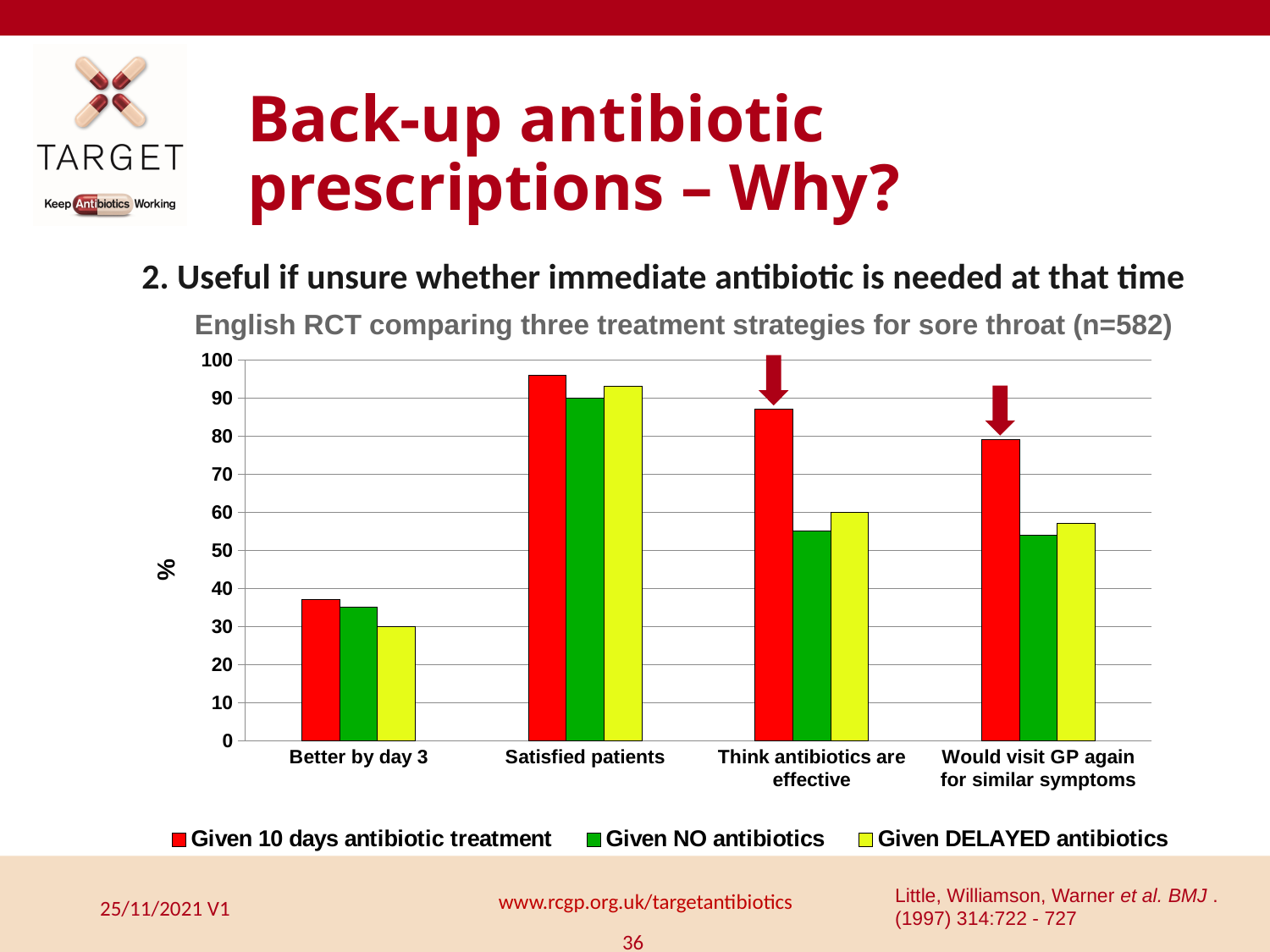
What kind of chart is shown on the slide? bar chart How many series does the chart's legend list? 3 Is the value for 'Given NO antibiotics' in the 'Think antibiotics are effective' category greater or less than 60? less In the 'Think antibiotics are effective' category, which is larger: 'Given 10 days antibiotic treatment' or 'Given DELAYED antibiotics'? Given 10 days antibiotic treatment Is the value for 'Given 10 days antibiotic treatment' in the 'Satisfied patients' category greater or less than 90? greater For the 'Given 10 days antibiotic treatment' series, which category has the highest value? Satisfied patients Is the value for 'Given DELAYED antibiotics' in the 'Better by day 3' category greater or less than 40? less What is the label on the chart's vertical axis? % What is the title of the chart? English RCT comparing three treatment strategies for sore throat (n=582) For the 'Given NO antibiotics' series, which category has the lowest value? Better by day 3 How many categories are shown along the x axis of the chart? 4